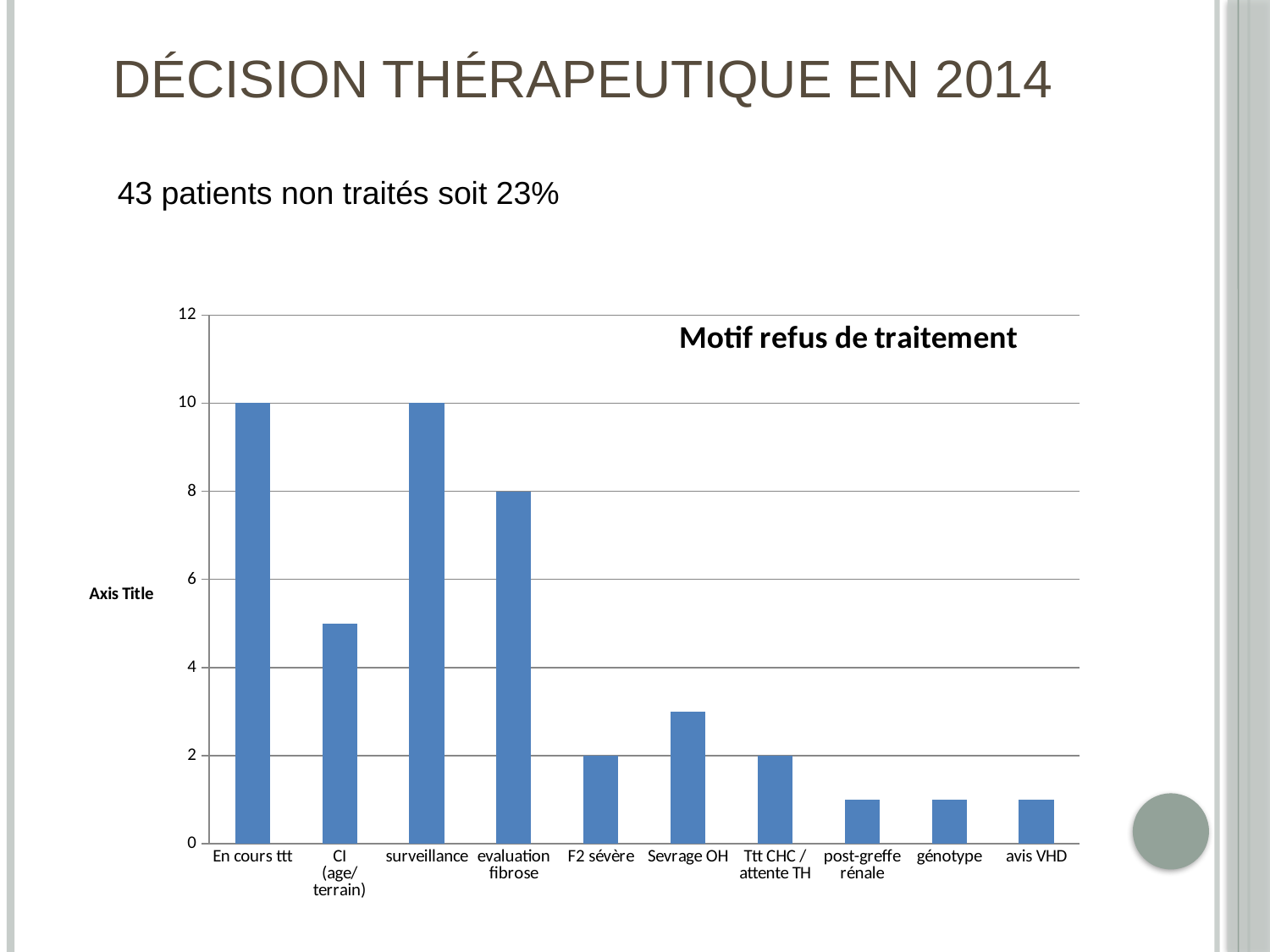
What is the title of the chart? Motif refus de traitement What kind of chart is shown on the slide? bar chart Is the value for CI (age/terrain) greater or less than 4? greater What is the value for F2 sévère? 2 What is the difference between the values for En cours ttt and evaluation fibrose? 2 What is the value for evaluation fibrose? 8 Is the value for Sevrage OH greater or less than 4? less Which is larger, the value for evaluation fibrose or the value for CI (age/terrain)? evaluation fibrose What is the value for En cours ttt in the Motif refus de traitement chart? 10 How many categories are shown on the x axis of the chart? 10 What is the value for surveillance? 10 Is the value for génotype greater or less than 2? less